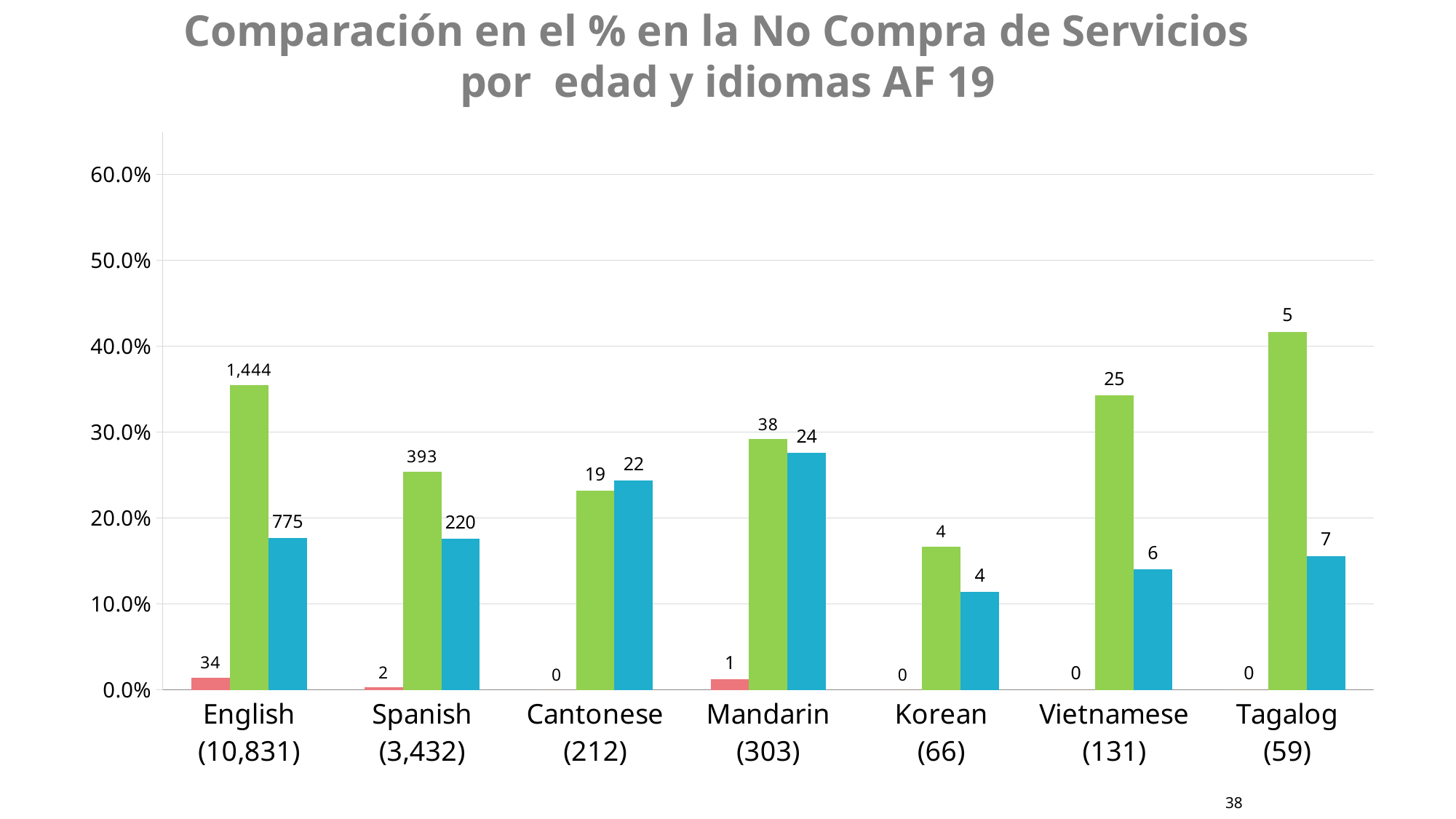
What is the difference between the data labels on the green bar (1,444) and the blue bar (775) for English (10,831)? 669 Is the green bar for Tagalog (59) greater or less than 40.0%? greater What is the data label on the pink bar for English (10,831)? 34 How many language categories are shown on the x axis? 7 What is the data label on the green bar for English (10,831)? 1,444 Which language category has the tallest green bar? Tagalog (59) Which language category has the lowest blue bar? Korean (66) What is the data label on the blue bar for Spanish (3,432)? 220 Is the green bar for Vietnamese (131) greater or less than 30.0%? greater What is the data label on the green bar for Mandarin (303)? 38 For English (10,831), which bar is taller, the green bar or the blue bar? the green bar What type of chart is shown on the slide? bar chart